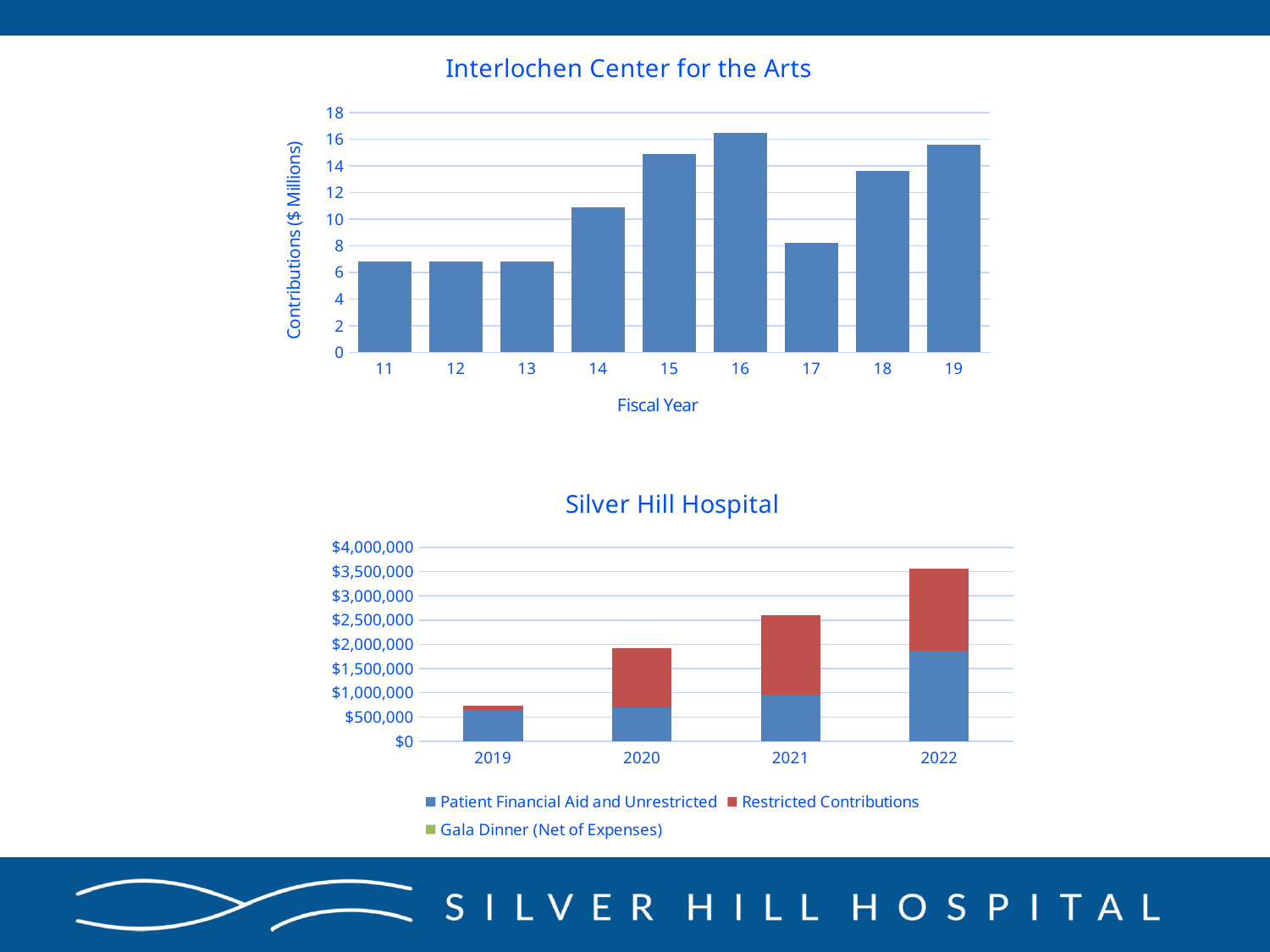
How many fiscal years are shown in the Interlochen Center for the Arts chart? 9 What is the y-axis label of the Interlochen Center for the Arts chart? Contributions ($ Millions) In the Silver Hill Hospital chart, is the total for 2022 greater or less than $3,000,000? greater In the Interlochen Center for the Arts chart, is the value for fiscal year 15 greater or less than 14? greater In the Interlochen Center for the Arts chart, which fiscal year has the highest contributions? 16 How many series does the legend of the Silver Hill Hospital chart list? 3 What kind of chart is the Interlochen Center for the Arts chart? bar chart In the Interlochen Center for the Arts chart, which is larger, the value for fiscal year 17 or fiscal year 18? 18 In the Silver Hill Hospital chart, which year has the lowest total bar? 2019 In the Interlochen Center for the Arts chart, is the value for fiscal year 11 greater or less than 8? less In the Silver Hill Hospital chart, which year has the highest total bar? 2022 In the Silver Hill Hospital chart, do the total bars rise or fall from 2019 to 2022? rise